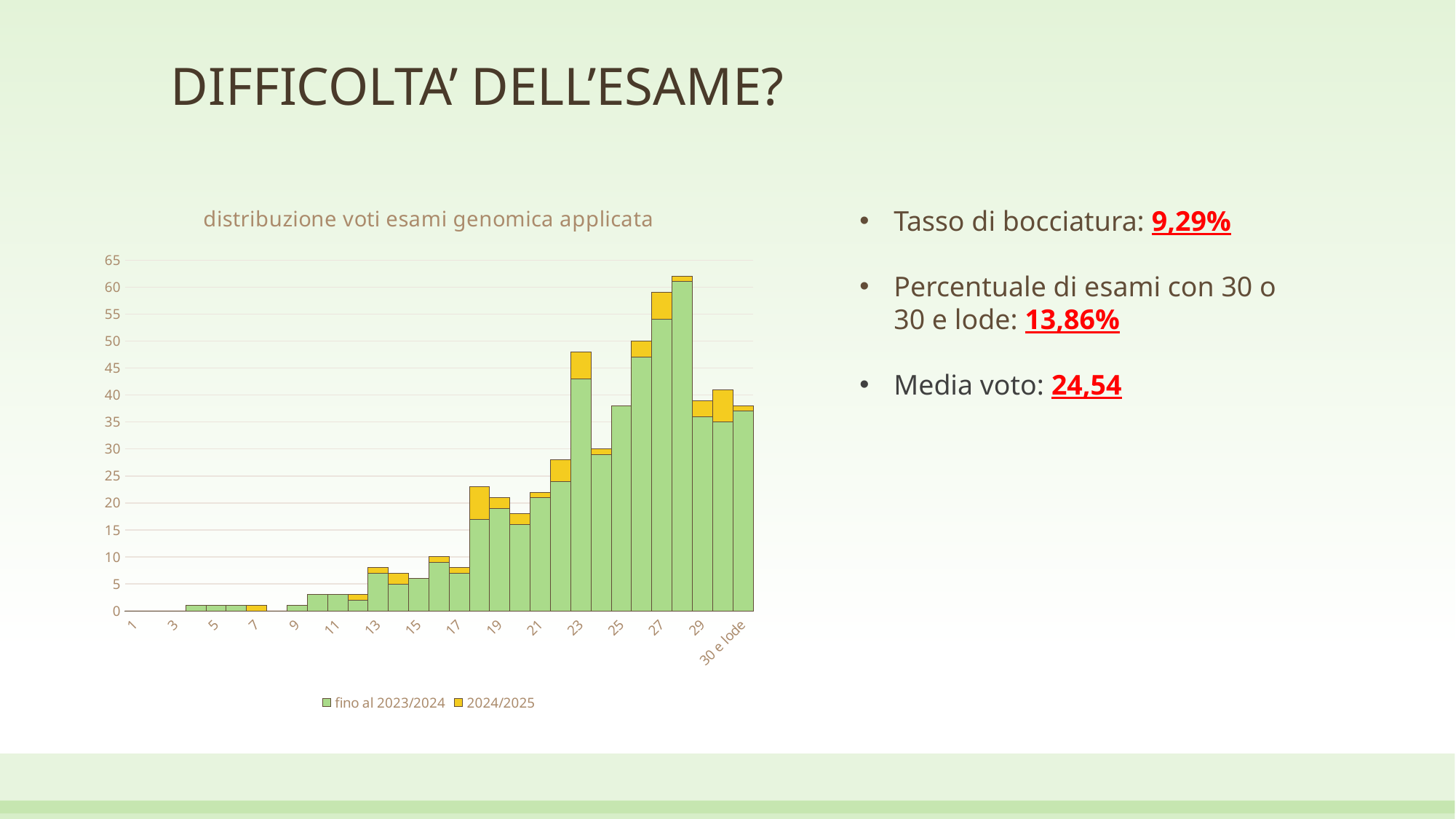
What kind of chart is shown on the slide? Stacked bar chart How many series does the chart legend list? 2 Which has the taller stacked bar, grade 28 or grade 29? 28 Is the total value for grade 28 greater or less than 60? greater What are the two series named in the chart legend? fino al 2023/2024 and 2024/2025 Which has the taller stacked bar, grade 23 or grade 24? 23 Is the total value for grade 25 greater or less than 40? less Is the total value for grade 13 greater or less than 10? less What is the title of the chart? distribuzione voti esami genomica applicata Which grade category has the tallest stacked bar? 28